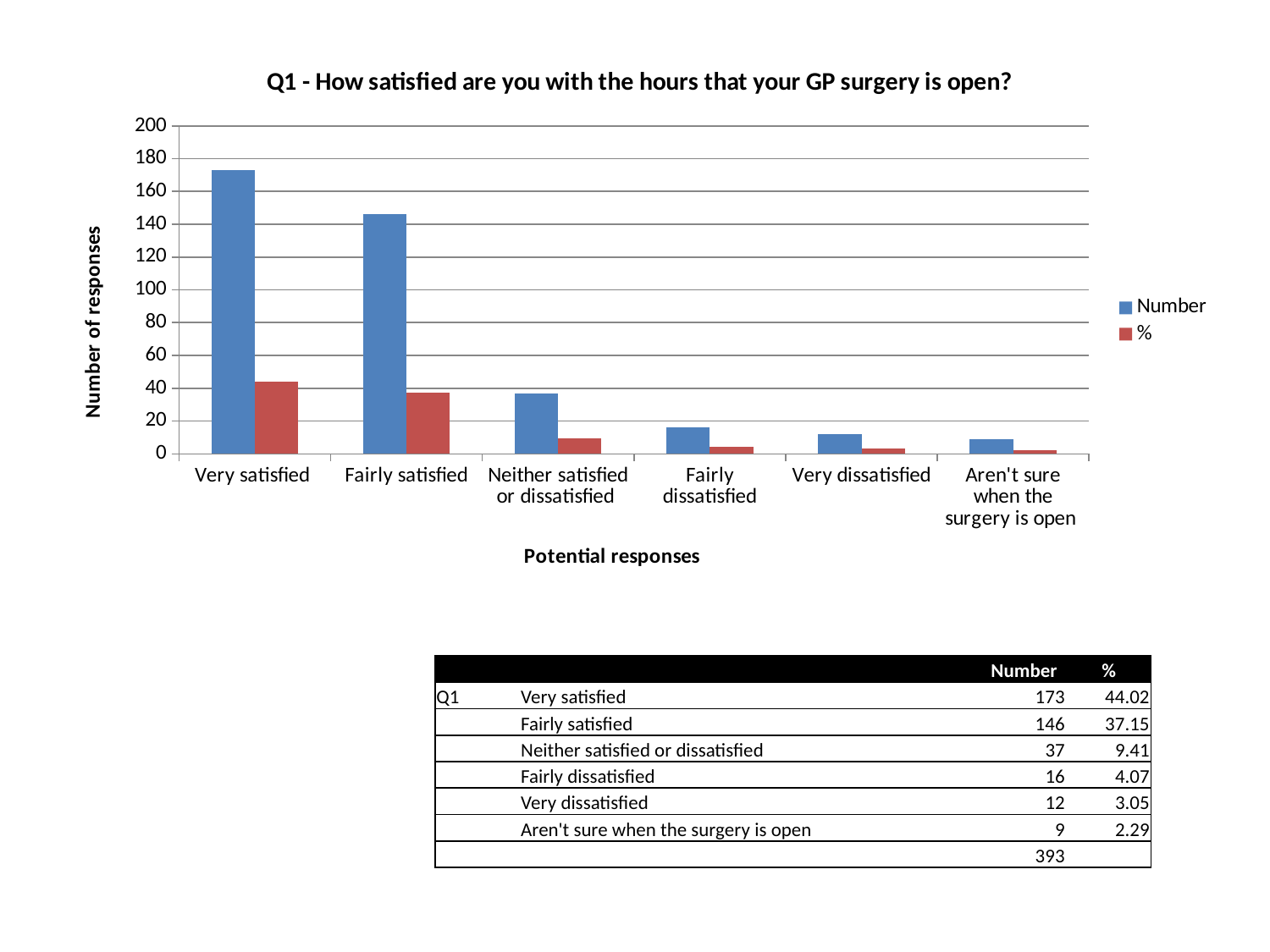
What is the title of the chart? Q1 - How satisfied are you with the hours that your GP surgery is open? How many series does the chart legend list? 2 Do the Number values rise or fall moving from left to right along the x axis? fall What is the difference in Number between Very satisfied and Fairly satisfied? 27 Which has a larger Number of responses, Fairly dissatisfied or Very dissatisfied? Fairly dissatisfied Which category has the highest Number of responses? Very satisfied Which category has the lowest Number of responses? Aren't sure when the surgery is open What type of chart is shown on the slide? bar chart How many response categories are shown on the x axis? 6 Is the Number value for Fairly satisfied greater or less than 140? greater What is the Number value for Very satisfied? 173 What is the % value for Fairly satisfied? 37.15